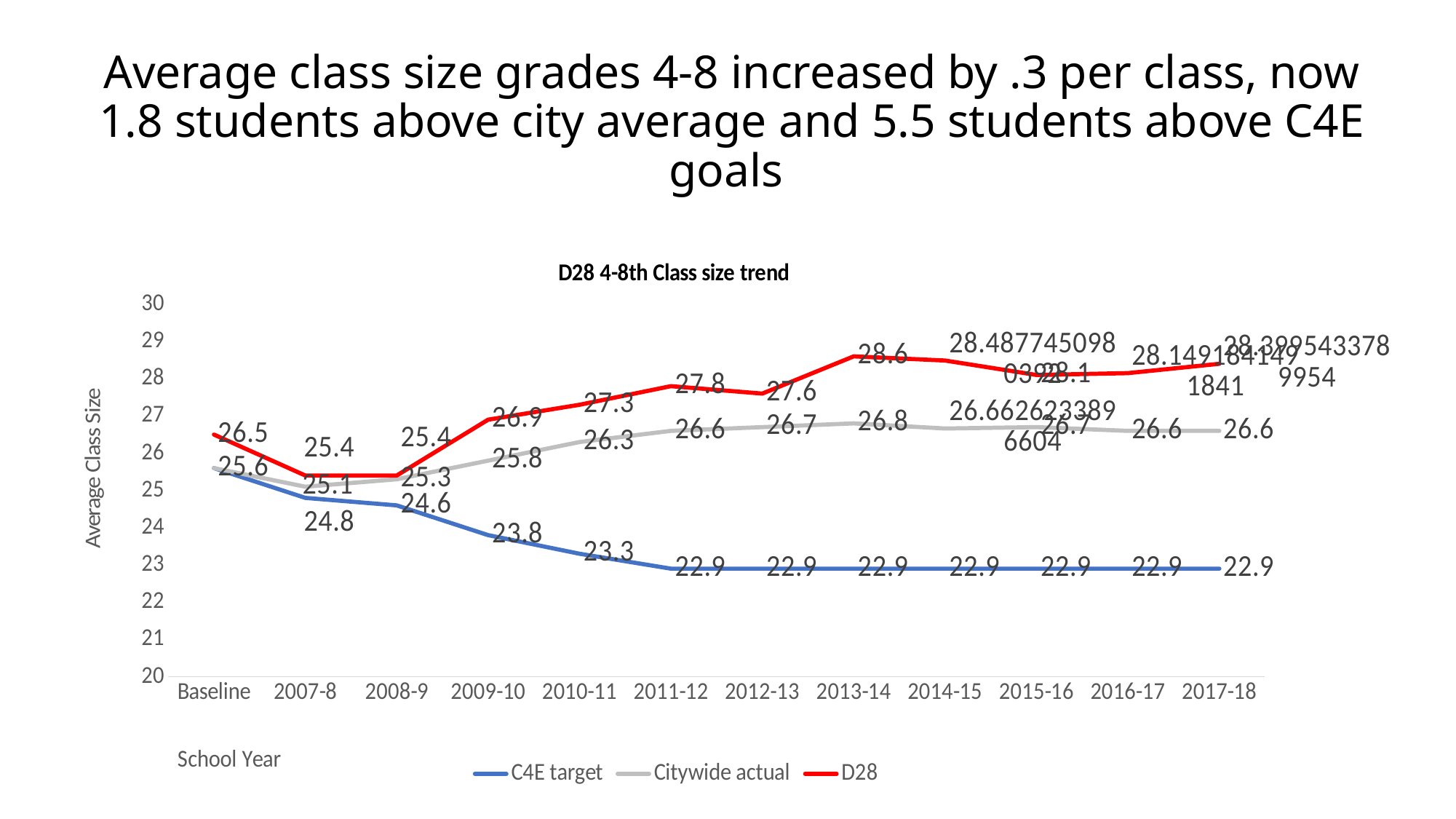
What is the C4E target value for 2007-8? 24.8 What is the D28 average class size for 2013-14? 28.6 Does the C4E target rise or fall from Baseline to 2011-12? fall What is the D28 value for 2011-12? 27.8 Which is higher in 2010-11, the D28 value or the Citywide actual value? D28 How many school years are shown on the x axis? 12 How many series does the legend list? 3 In which school year is the Citywide actual value lowest? 2007-8 What is the Citywide actual value for 2017-18? 26.6 What is the Citywide actual value for 2012-13? 26.7 What is the difference between the D28 value and the C4E target value in 2013-14? 5.7 Is the D28 value for 2017-18 greater or less than 28? greater